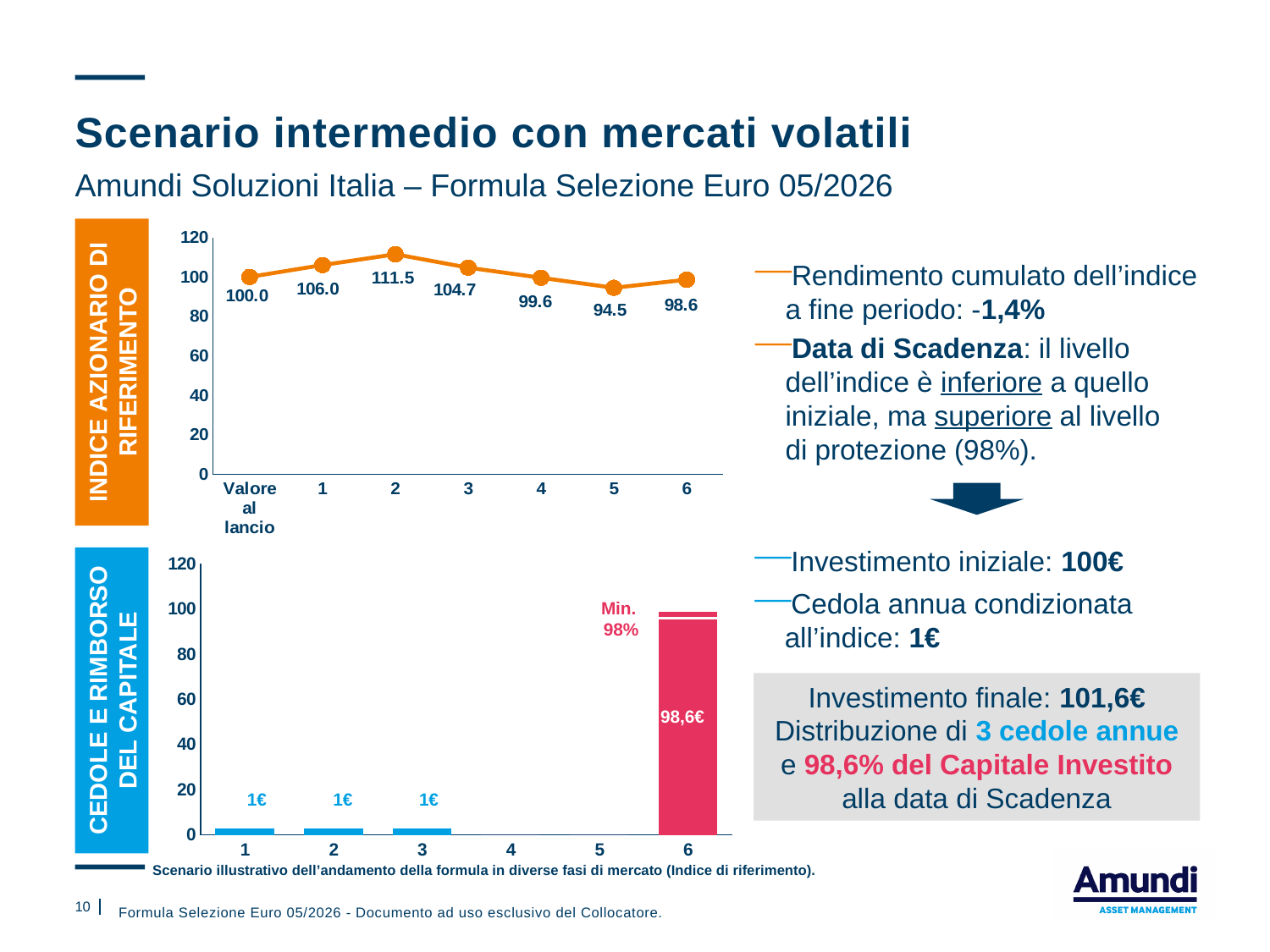
In the top chart (INDICE AZIONARIO DI RIFERIMENTO), what is the difference between the value at point 2 and the value at point 5? 17.0 In the top chart (INDICE AZIONARIO DI RIFERIMENTO), what is the index value at point 2? 111.5 What type of chart is the bottom chart (CEDOLE E RIMBORSO DEL CAPITALE)? Bar chart In the top chart (INDICE AZIONARIO DI RIFERIMENTO), how many data points are plotted? 7 In the top chart (INDICE AZIONARIO DI RIFERIMENTO), at which point is the index lowest? 5 In the bottom chart (CEDOLE E RIMBORSO DEL CAPITALE), what is the value of the bar at period 1? 1€ In the top chart (INDICE AZIONARIO DI RIFERIMENTO), what is the index value at point 5? 94.5 In the top chart (INDICE AZIONARIO DI RIFERIMENTO), which is larger: the value at point 3 or the value at point 6? Point 3 In the top chart (INDICE AZIONARIO DI RIFERIMENTO), what is the value at 'Valore al lancio'? 100.0 In the bottom chart (CEDOLE E RIMBORSO DEL CAPITALE), what is the value of the bar at period 6? 98,6€ In the top chart (INDICE AZIONARIO DI RIFERIMENTO), at which point is the index highest? 2 What type of chart is the top chart (INDICE AZIONARIO DI RIFERIMENTO)? Line chart